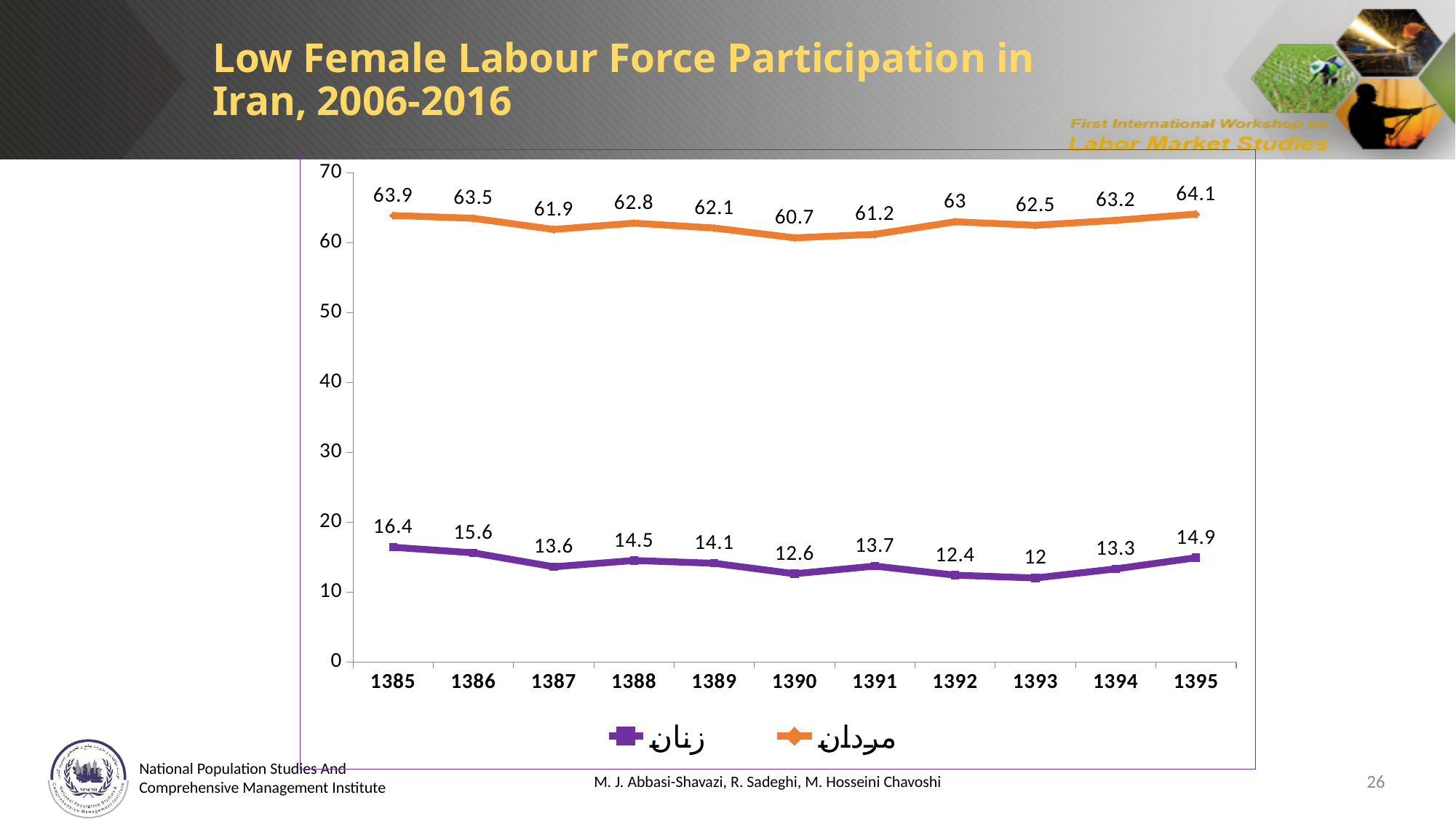
Which is larger: the purple series (زنان) value in 1385 or in 1395? 1385 In which year is the purple series (زنان) at its lowest? 1393 What is the title of the chart on the slide? Low Female Labour Force Participation in Iran, 2006-2016 What is the value of the purple series (زنان) in 1385? 16.4 How many series does the legend list? 2 What type of chart is shown on the slide? line chart In which year is the orange series (مردان) at its highest? 1395 What is the value of the orange series (مردان) in 1390? 60.7 Is the value of the orange series (مردان) in 1387 greater or less than 60? greater How many years are plotted along the x axis? 11 What is the difference between the orange series (مردان) and the purple series (زنان) in 1395? 49.2 What is the value of the purple series (زنان) in 1393? 12